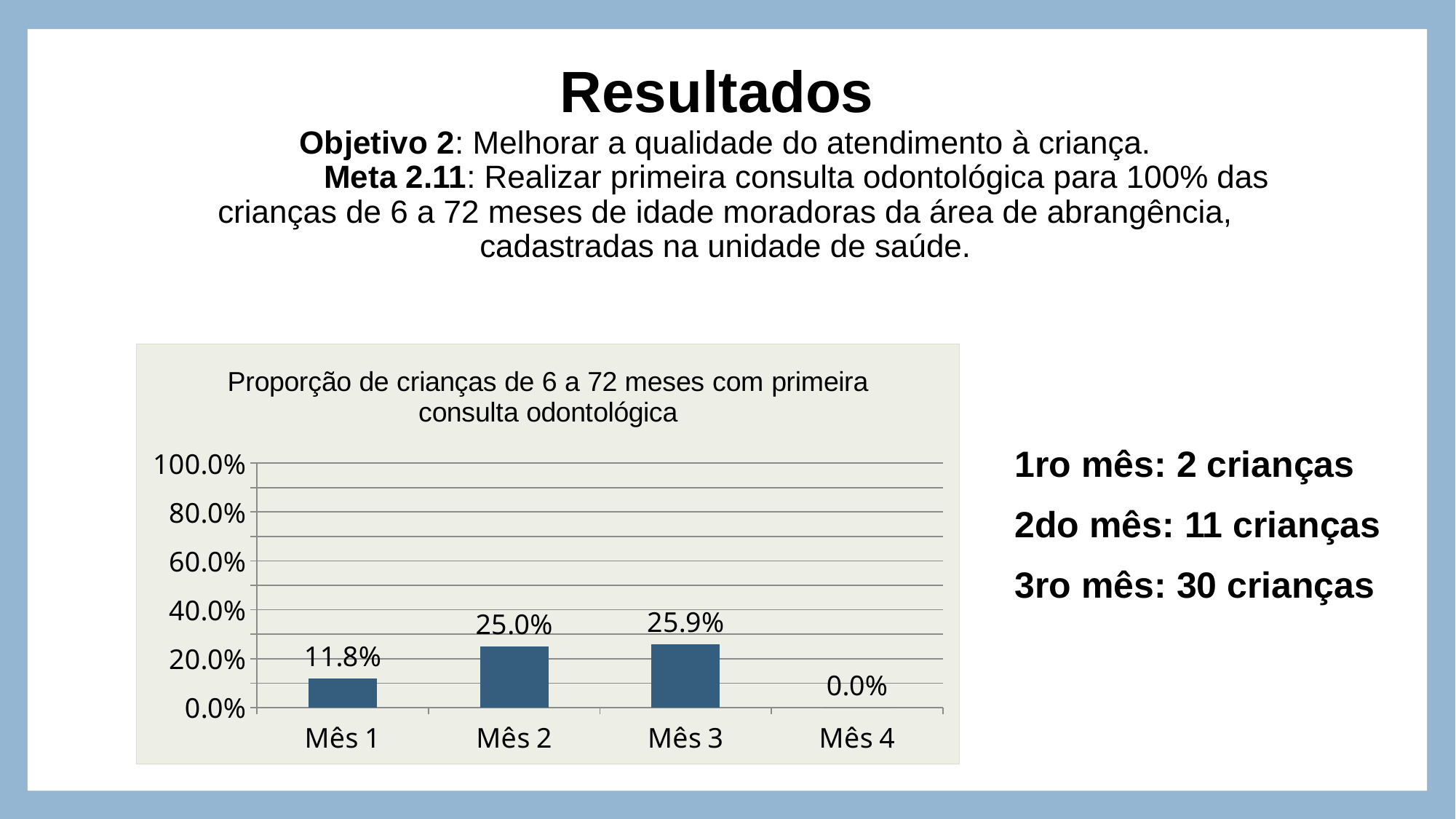
What is the value for Mês 2? 25.0% What is the title of the chart? Proporção de crianças de 6 a 72 meses com primeira consulta odontológica Which month has the highest value? Mês 3 What kind of chart is shown on the slide? Bar chart Which month has the lowest value? Mês 4 What is the value for Mês 4? 0.0% What is the value for Mês 1? 11.8% Which is larger, the value for Mês 1 or the value for Mês 2? Mês 2 What is the difference between the values for Mês 2 and Mês 1? 13.2% How many months are shown on the x axis? 4 What is the difference between the values for Mês 3 and Mês 2? 0.9% What is the value for Mês 3? 25.9%